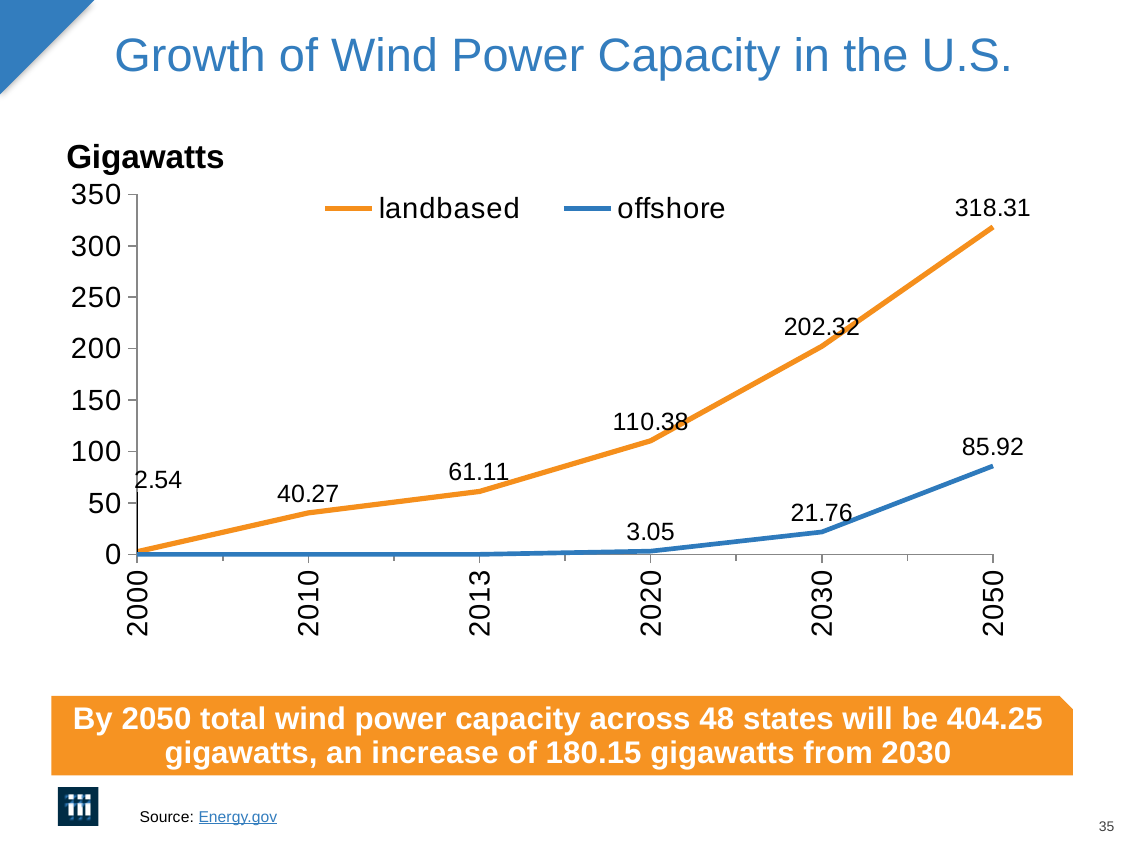
Does the landbased capacity rise or fall from 2000 to 2050? rise How many series does the legend list? 2 In which year is the landbased capacity highest? 2050 How many years are shown on the x axis? 6 What is the offshore value for 2020? 3.05 Which is larger in 2050, the landbased or the offshore capacity? landbased What is the difference between the landbased values for 2050 and 2030? 115.99 What is the offshore wind power capacity in 2030? 21.76 What is the landbased value for 2013? 61.11 In which year is the landbased capacity lowest? 2000 What is the landbased wind power capacity in 2050? 318.31 What type of chart is shown on the slide? line chart